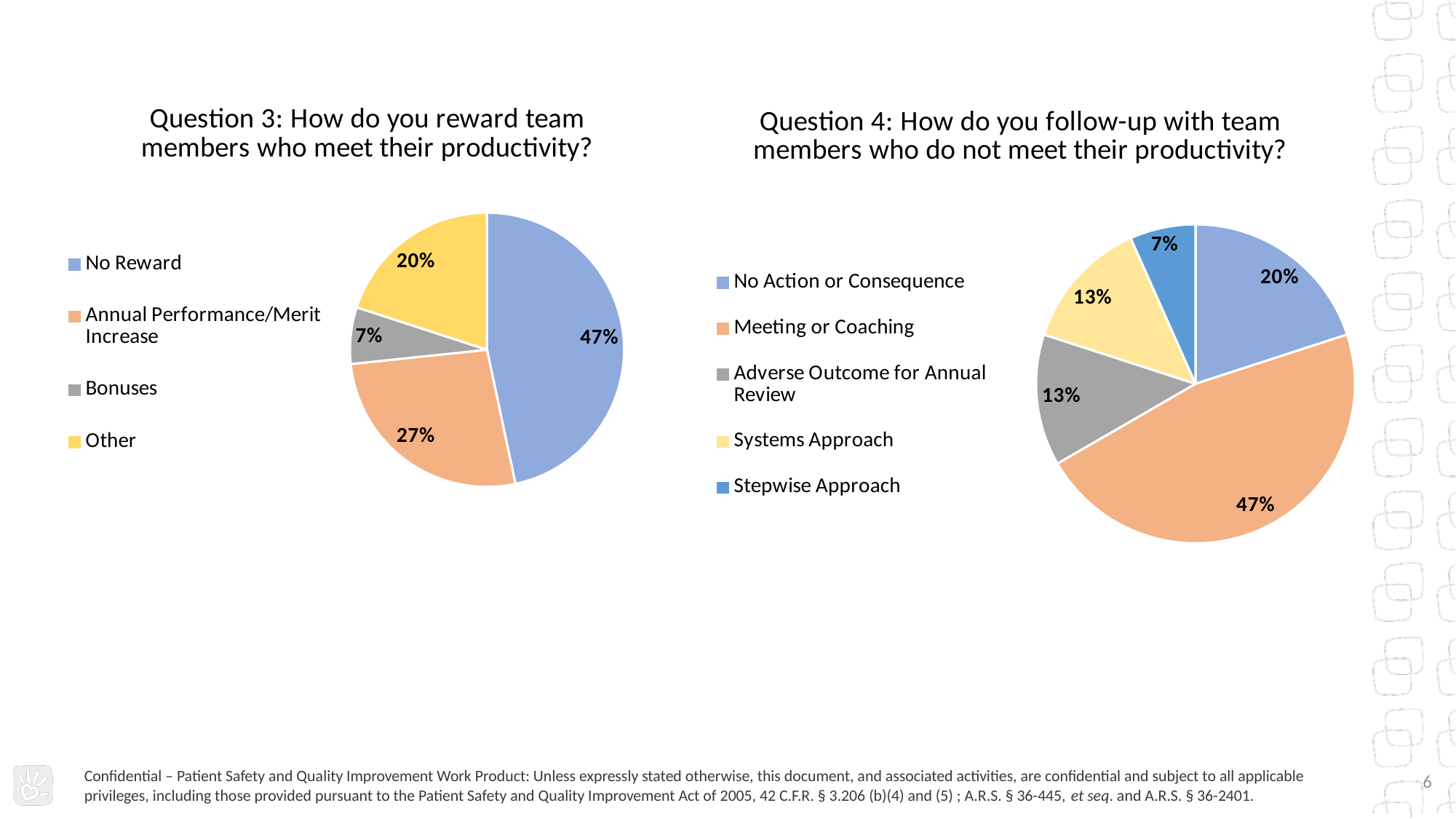
What type of chart is used for Question 4? Pie chart In the Question 4 pie chart, which category has the largest slice? Meeting or Coaching In the Question 3 pie chart, what is the difference between the No Reward share and the Other share? 27% In the Question 3 pie chart, what share is labelled for Annual Performance/Merit Increase? 27% How many categories does the Question 3 pie chart show? 4 In the Question 4 pie chart, what colour is the Adverse Outcome for Annual Review slice? Grey In the Question 3 pie chart, which category has the smallest slice? Bonuses In the Question 3 pie chart, what share is labelled for No Reward? 47% In the Question 4 pie chart, what share is labelled for Meeting or Coaching? 47% How many categories does the legend of the Question 4 pie chart list? 5 In the Question 4 pie chart, what share is labelled for Stepwise Approach? 7% In the Question 4 pie chart, which is larger: No Action or Consequence or Systems Approach? No Action or Consequence